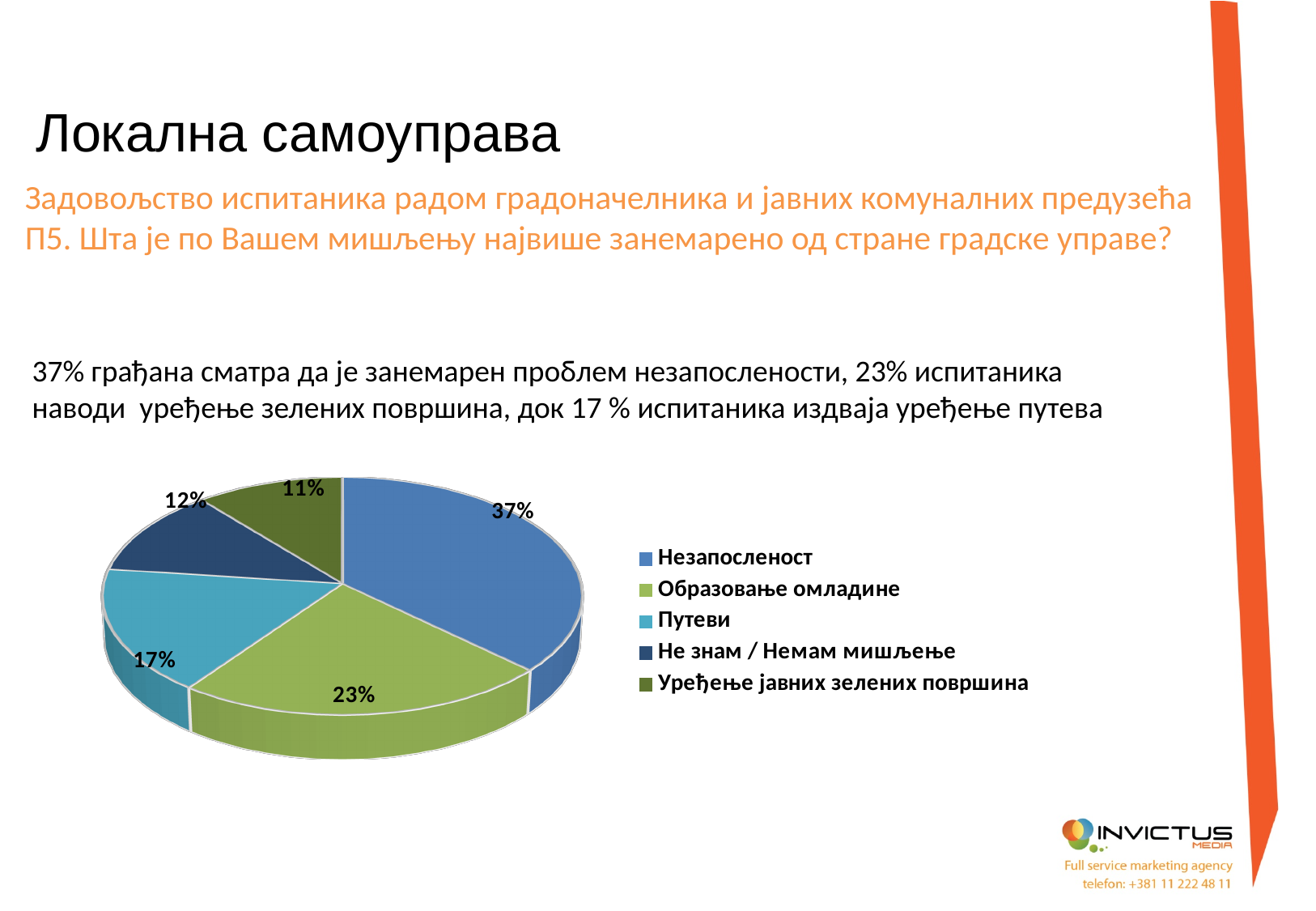
What percentage is shown for Не знам / Немам мишљење in the pie chart? 12% Which slice is larger, Путеви or Не знам / Немам мишљење? Путеви Which colour represents Незапосленост in the pie chart? blue What percentage of the pie chart is the slice for Незапосленост? 37% What kind of chart is shown on the slide? pie chart How many slices does the pie chart have? 5 What percentage is shown for Путеви in the pie chart? 17% What percentage is shown for Образовање омладине in the pie chart? 23% What is the difference in percentage points between Незапосленост and Образовање омладине? 14 Which category has the largest slice in the pie chart? Незапосленост What percentage is shown for Уређење јавних зелених површина in the pie chart? 11% Which category has the smallest slice in the pie chart? Уређење јавних зелених површина